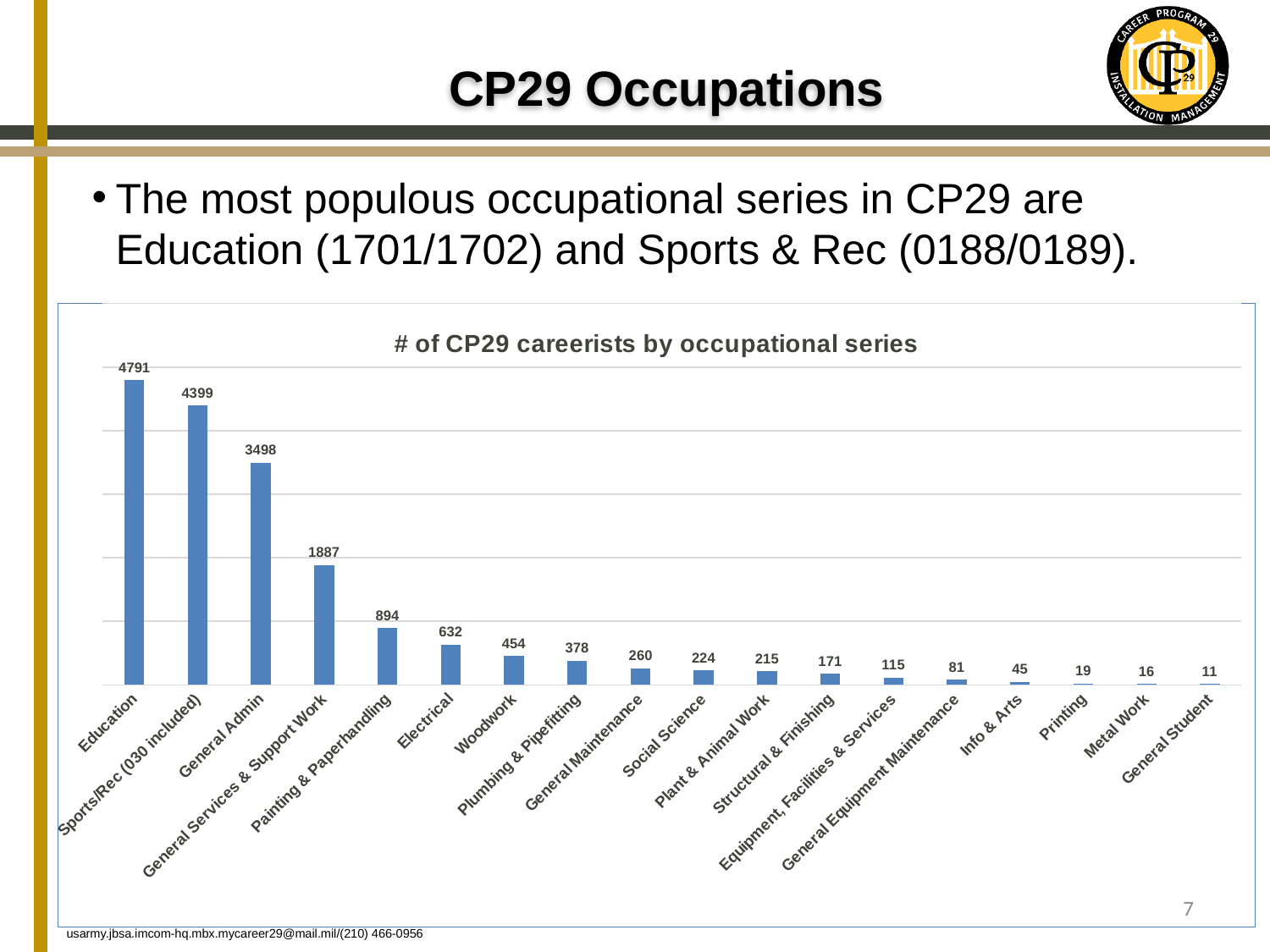
Which occupational series has the highest number of careerists? Education Which is larger, the value for Social Science or the value for Plant & Animal Work? Social Science What is the value for Woodwork? 454 How many occupational series are shown in the chart? 18 What is the value for General Admin? 3498 What is the difference between the values for Education and Sports/Rec (030 included)? 392 What is the value for Info & Arts? 45 What is the title of the chart? # of CP29 careerists by occupational series What kind of chart is shown on the slide? Bar chart Which occupational series has the lowest number of careerists? General Student What is the difference between the values for Painting & Paperhandling and Electrical? 262 What is the value for Education? 4791